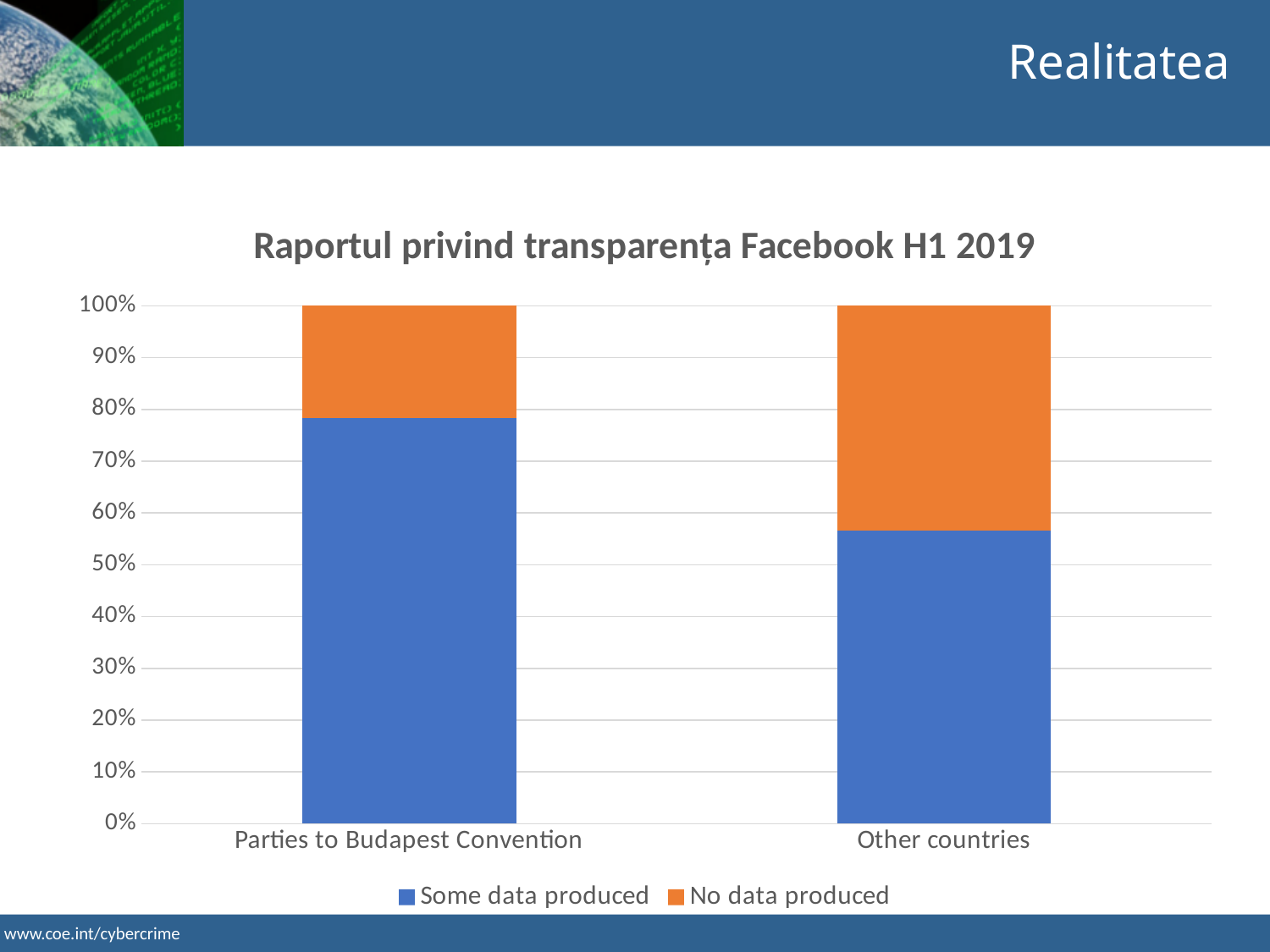
What kind of chart is shown on the slide? bar chart Is the 'No data produced' value for Other countries greater or less than 40%? greater How many series does the legend list? 2 Is the 'Some data produced' value for Other countries greater or less than 60%? less Is the 'Some data produced' value for Parties to Budapest Convention greater or less than 70%? greater What is the title of the chart? Raportul privind transparența Facebook H1 2019 Which category has the larger 'Some data produced' share: Parties to Budapest Convention or Other countries? Parties to Budapest Convention Which category has the larger 'No data produced' share: Parties to Budapest Convention or Other countries? Other countries Which colour represents 'No data produced' in the chart? orange How many categories are shown on the x axis of the chart? 2